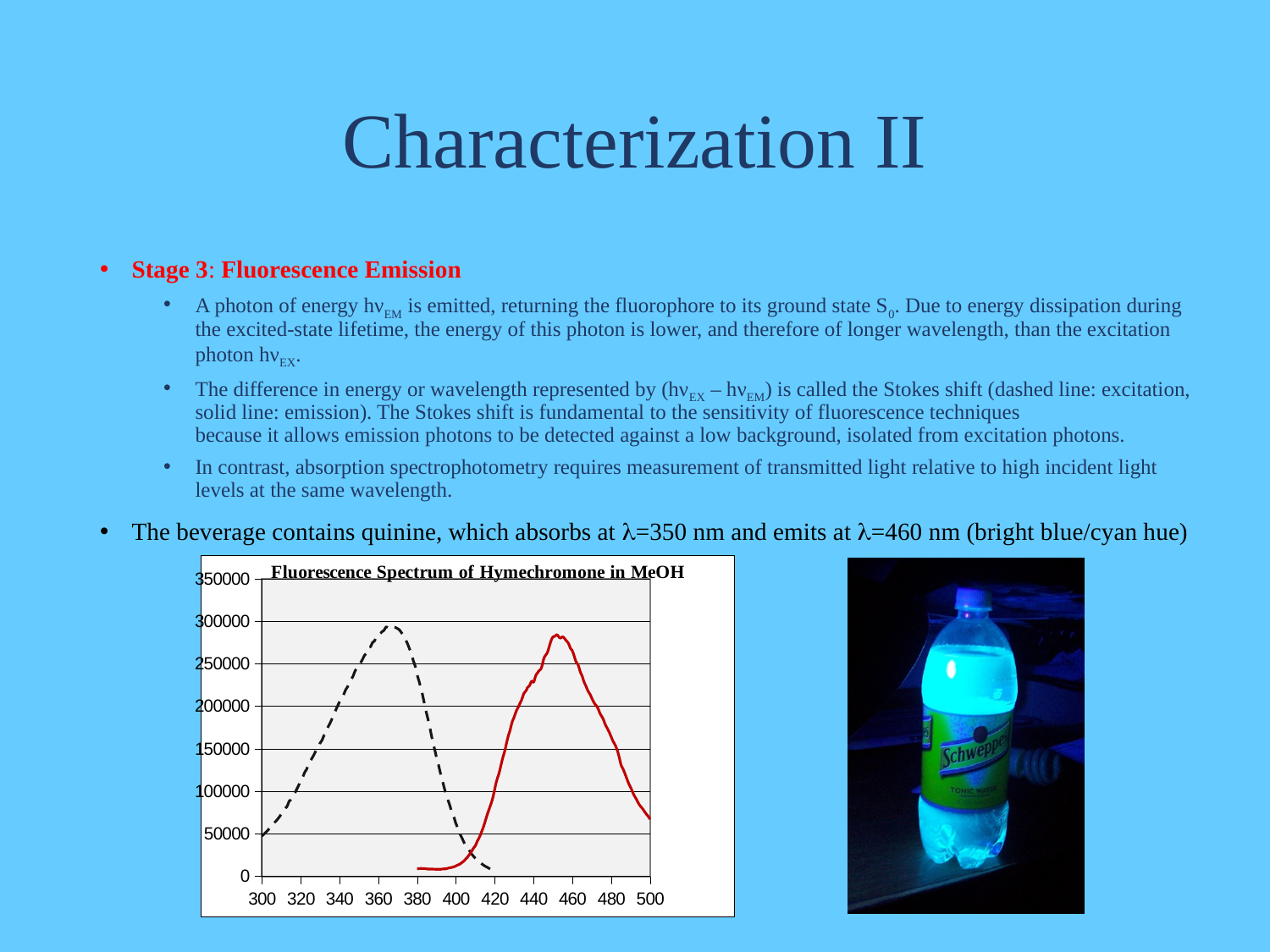
Is the value of the dashed line at 300 nm greater or less than 100000? less Is the peak value of the dashed line greater or less than 250000? greater Does the dashed line rise or fall between 300 nm and 360 nm? rise Does the solid red line rise or fall between 460 nm and 500 nm? fall Is the peak value of the solid red line greater or less than 250000? greater How many lines (series) are plotted on the chart? 2 What kind of chart is shown on the slide? line chart What is the highest value shown on the chart's y axis? 350000 What is the title of the chart on the slide? Fluorescence Spectrum of Hymechromone in MeOH